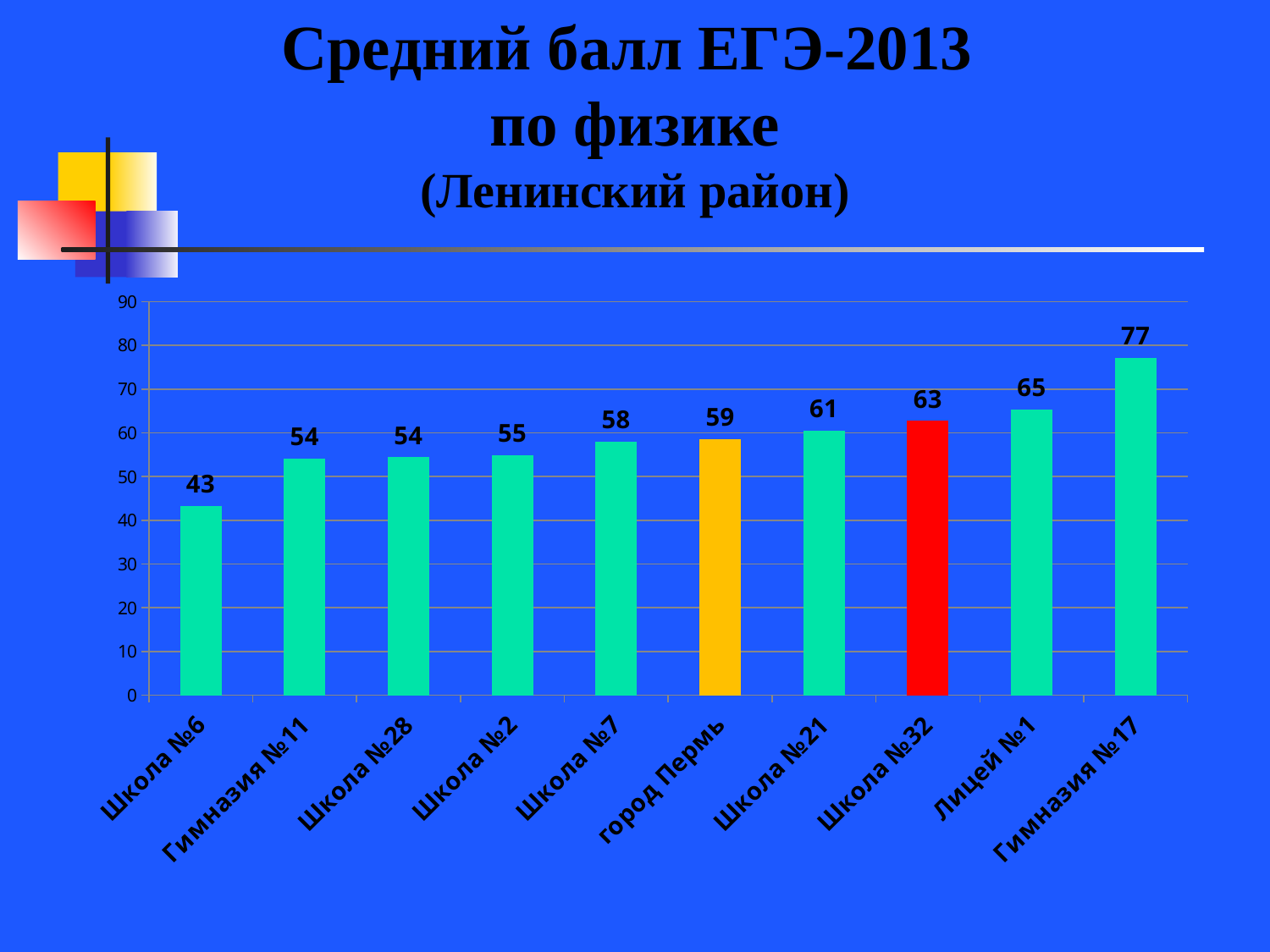
What value is shown for город Пермь? 59 What value is shown for Школа №32? 63 What kind of chart is shown on the slide? Bar chart Which category has the lowest value? Школа №6 What is the difference between the values for Гимназия №17 and Школа №6? 34 Which is larger, the value for Школа №21 or the value for Школа №7? Школа №21 What is the average physics score shown for Школа №6? 43 How many categories are shown on the x axis? 10 What is the difference between the values for Лицей №1 and город Пермь? 6 Which category's bar is coloured red? Школа №32 Which category has the highest value? Гимназия №17 Do the values generally rise or fall from left to right along the x axis? Rise